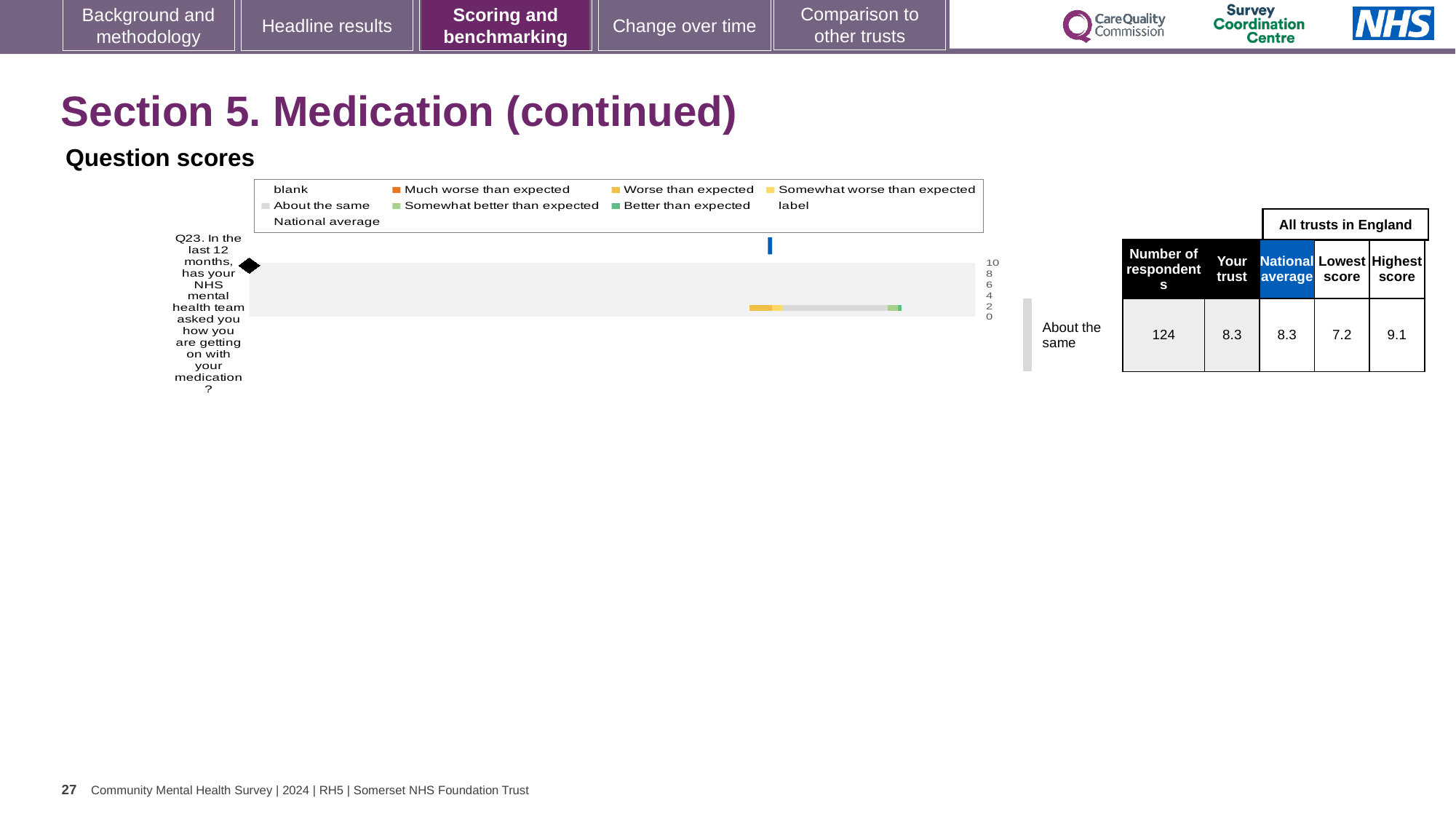
How many survey questions are plotted in the chart? 1 What is the lowest score among all trusts in England for Q23? 7.2 What is the 'Your trust' score for Q23? 8.3 What is the difference between the highest score and the lowest score for Q23? 1.9 Is the 'Your trust' score for Q23 larger than, smaller than, or equal to the national average? equal What is the highest score among all trusts in England for Q23? 9.1 What benchmark category is shown for Q23 next to the chart? About the same What is the highest value shown on the chart's numeric axis? 10 Which question is plotted in the chart? Q23. In the last 12 months, has your NHS mental health team asked you how you are getting on with your medication? What is the national average score for Q23? 8.3 What kind of chart is shown on the slide? bar chart How many respondents answered Q23? 124